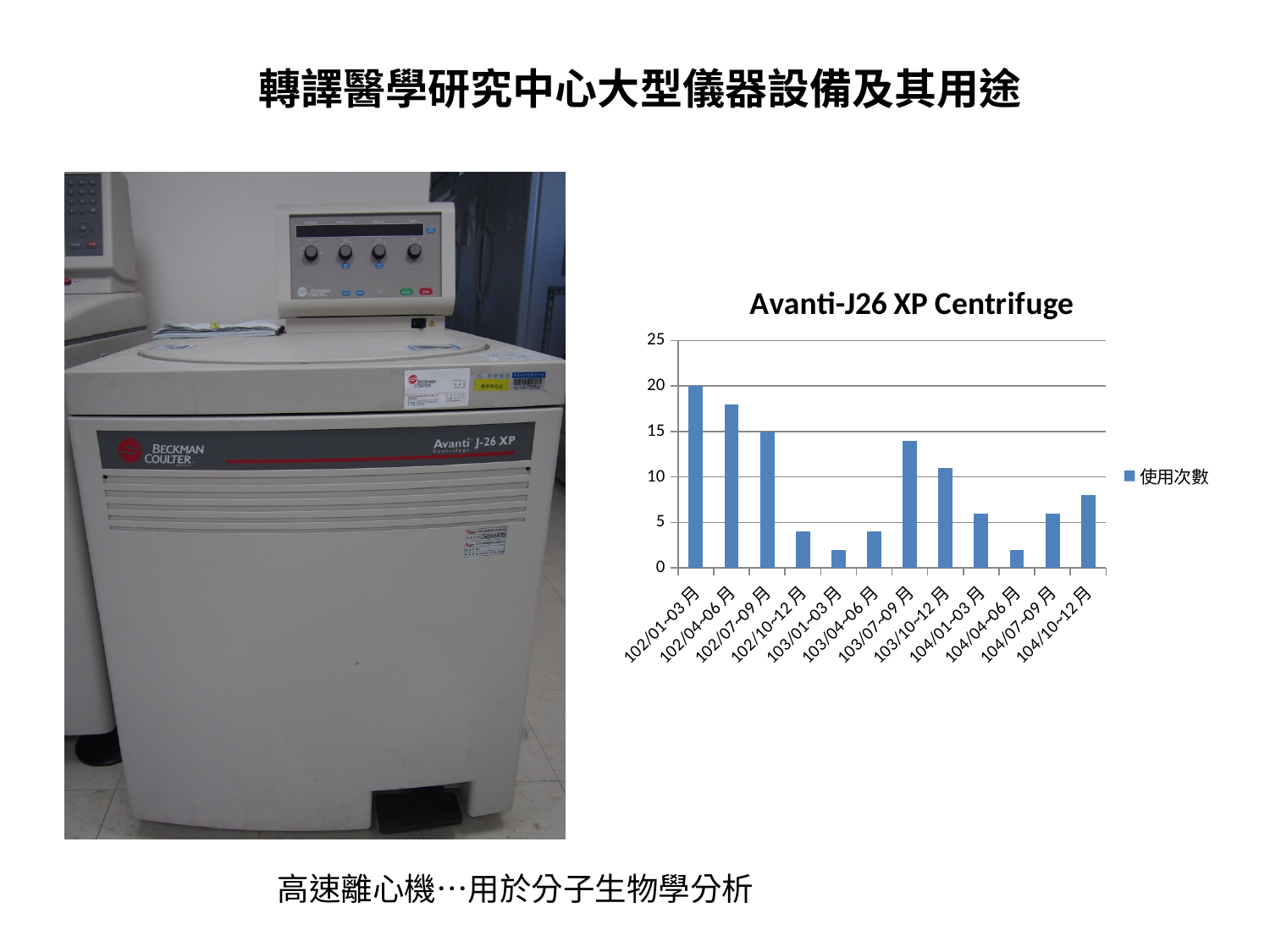
Is the value for 103/01-03月 greater or less than 5? less How many categories (quarters) are shown on the x axis of the Avanti-J26 XP Centrifuge chart? 12 What is the value for 102/07-09月 in the Avanti-J26 XP Centrifuge chart? 15 Do the values rise or fall across the first four quarters, from 102/01-03月 to 102/10-12月? fall What is the legend entry of the Avanti-J26 XP Centrifuge chart? 使用次數 Which quarter has the highest value in the Avanti-J26 XP Centrifuge chart? 102/01-03月 What is the value for 102/01-03月 in the Avanti-J26 XP Centrifuge chart? 20 What kind of chart is the Avanti-J26 XP Centrifuge chart? bar chart How many series does the legend of the Avanti-J26 XP Centrifuge chart list? 1 Is the value for 103/07-09月 greater or less than 10? greater Is the value for 102/04-06月 greater or less than 15? greater Which is larger in the Avanti-J26 XP Centrifuge chart, the value for 103/07-09月 or the value for 103/10-12月? 103/07-09月